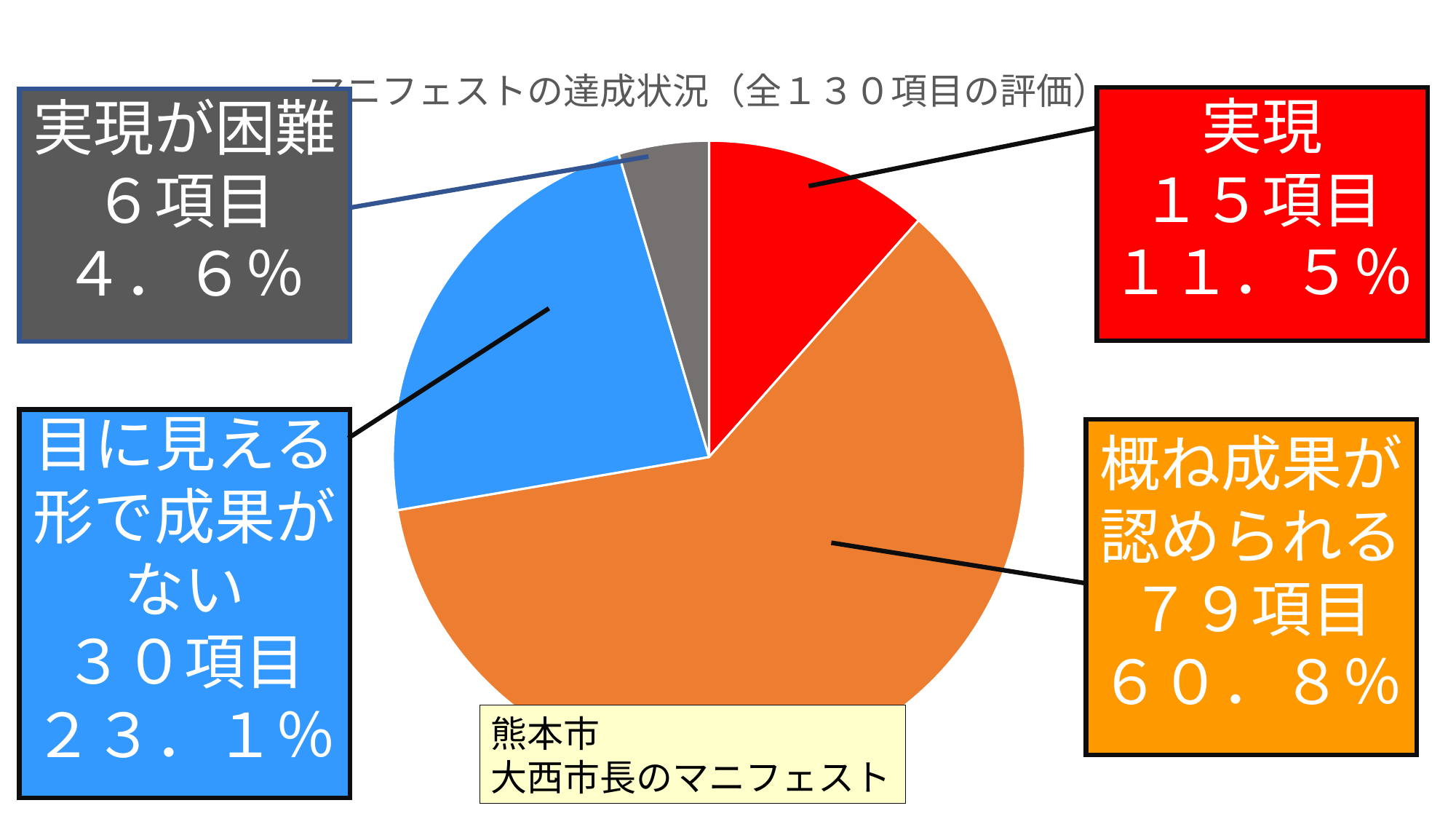
What colour is the slice for 実現? red How many slices does the pie chart have? 4 What percentage of the pie does 概ね成果が認められる account for? ６０．８％ What is the difference in number of items between 概ね成果が認められる and 目に見える形で成果がない? ４９ How many items (項目) are in the 実現 category? １５項目 What percentage is shown for 実現が困難? ４．６％ What is the total number of items evaluated according to the chart title? １３０項目 How many items are in the 目に見える形で成果がない category? ３０項目 What kind of chart is shown on the slide? pie chart Which category has the largest share of the pie? 概ね成果が認められる Which category has the smallest share of the pie? 実現が困難 Which has more items, 実現 or 目に見える形で成果がない? 目に見える形で成果がない